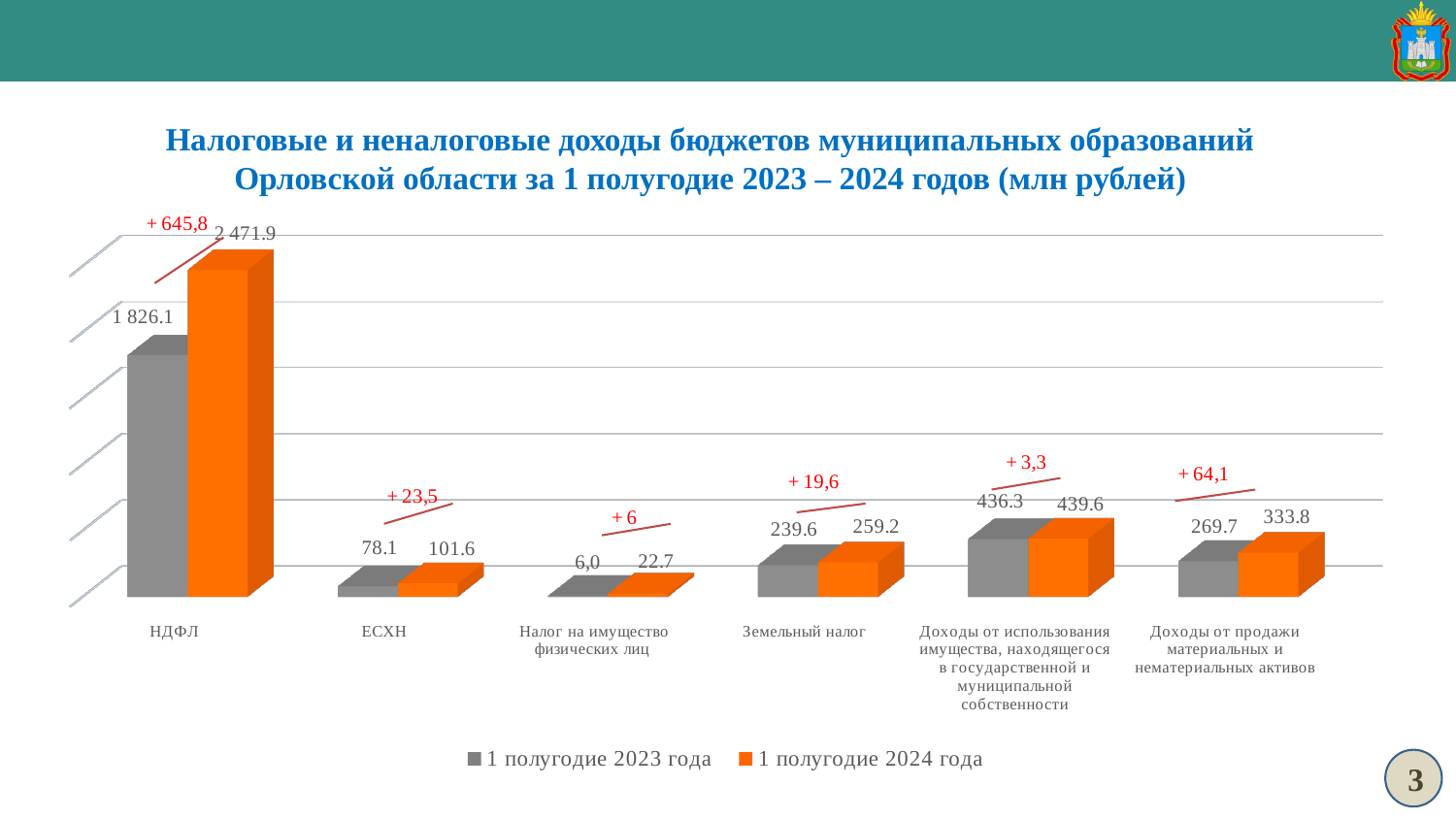
Which category has the lowest value in the series 1 полугодие 2023 года? Налог на имущество физических лиц Which is larger for Земельный налог: the value for 1 полугодие 2023 года or 1 полугодие 2024 года? 1 полугодие 2024 года How many series does the legend list? 2 How many categories are shown on the x axis of the chart? 6 What is the value for Земельный налог in the series 1 полугодие 2024 года? 259.2 What growth figure is annotated in red above the НДФЛ bars? + 645,8 What is the value for НДФЛ in the series 1 полугодие 2024 года? 2 471.9 What is the value for ЕСХН in the series 1 полугодие 2023 года? 78.1 What is the value for Налог на имущество физических лиц in the series 1 полугодие 2023 года? 6,0 What kind of chart is shown on the slide? Bar chart Which category has the highest value in the series 1 полугодие 2024 года? НДФЛ What is the difference between the 2024 and 2023 values for Доходы от продажи материальных и нематериальных активов? 64.1